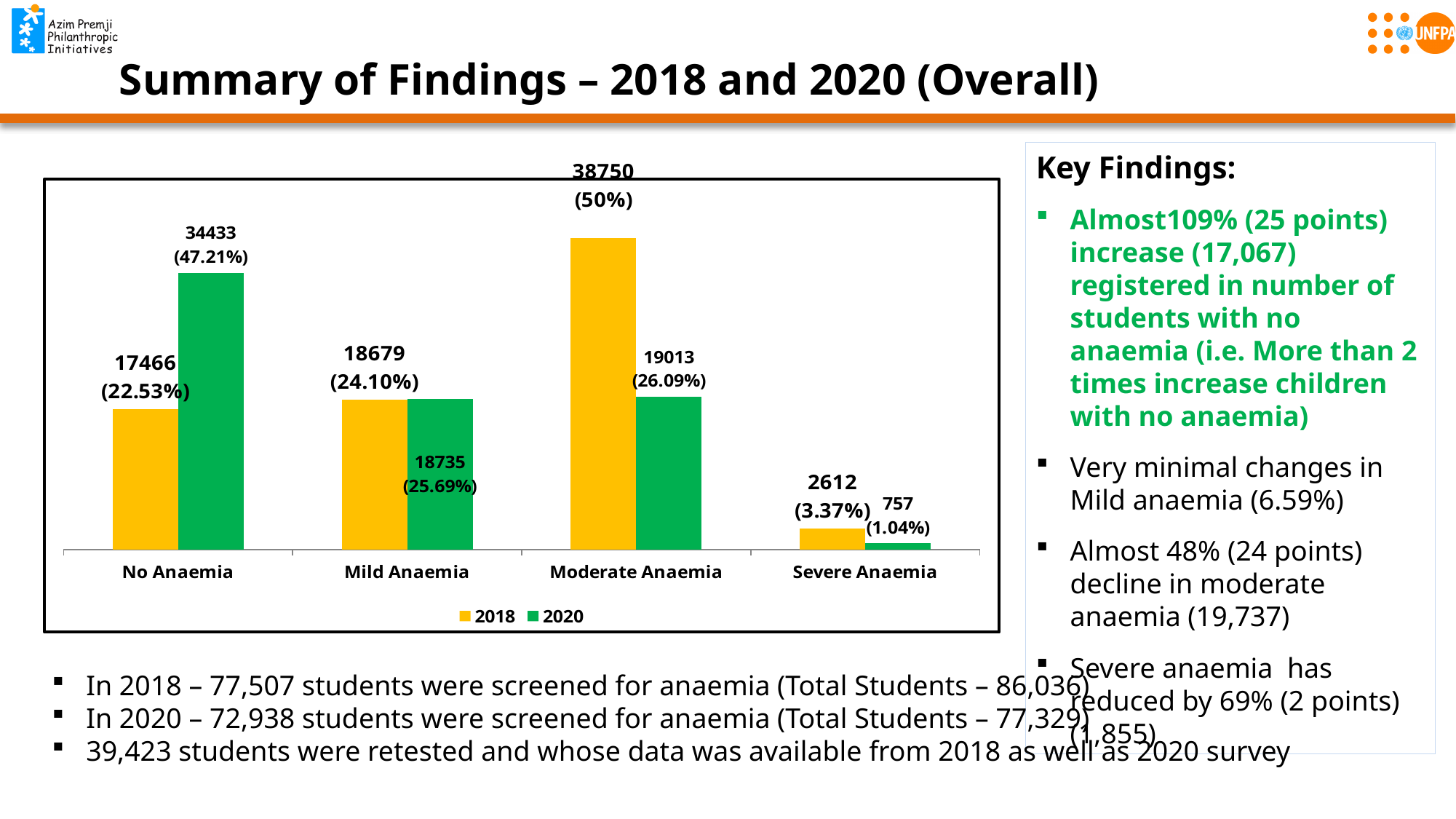
What is the 2020 value for No Anaemia? 34433 What is the difference between the 2018 and 2020 values for Moderate Anaemia? 19737 What percentage is shown for Moderate Anaemia in 2018? 50% What is the 2018 value for No Anaemia? 17466 What is the difference between the 2020 and 2018 values for No Anaemia? 16967 How many categories are shown on the x axis? 4 What kind of chart is shown on the slide? Bar chart Which is larger for Severe Anaemia, the 2018 value or the 2020 value? 2018 Which category has the highest 2018 value? Moderate Anaemia How many series does the legend list? 2 Which category has the lowest 2020 value? Severe Anaemia What is the 2020 value for Severe Anaemia? 757